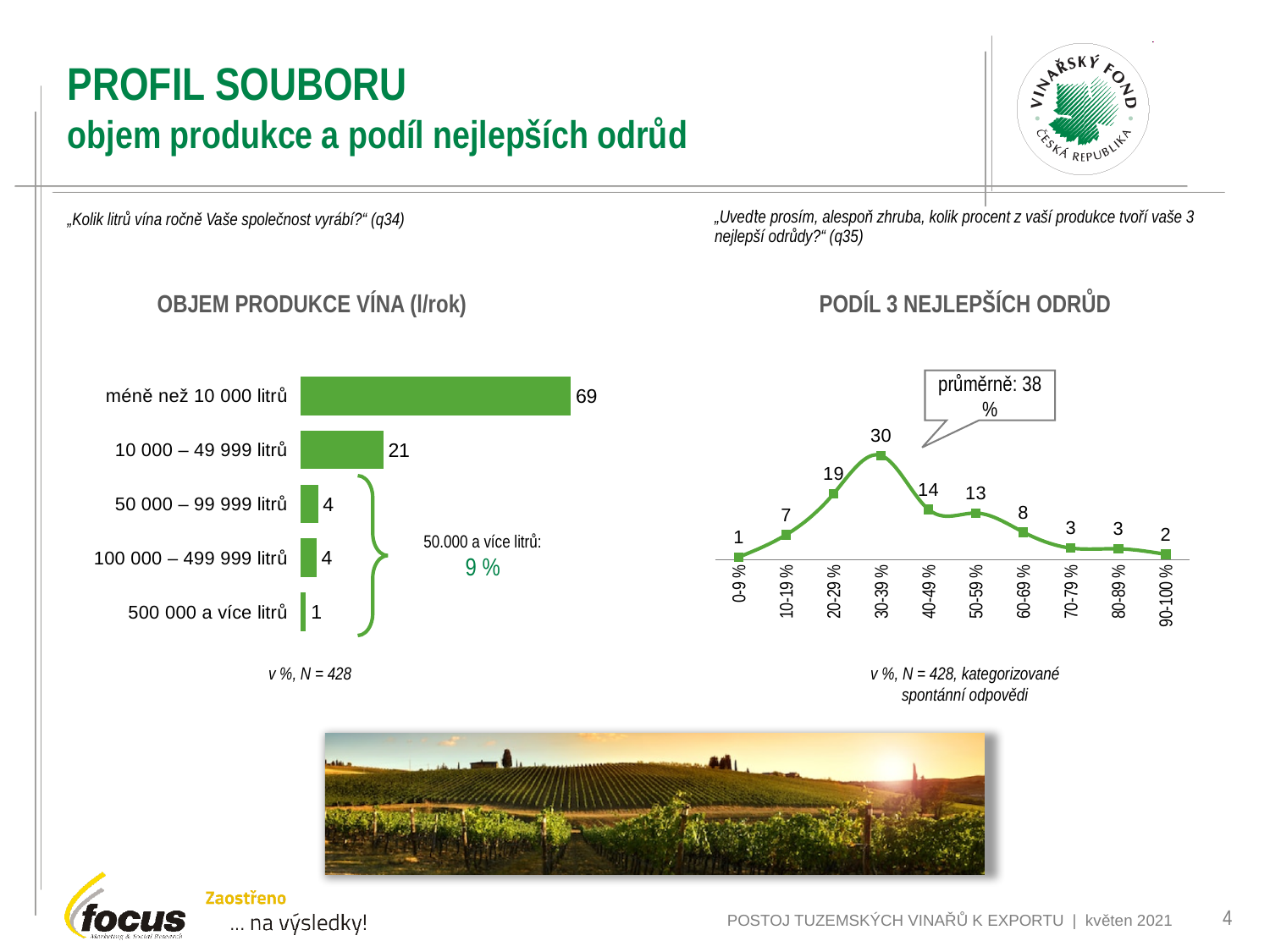
In the chart titled OBJEM PRODUKCE VÍNA (l/rok), how many categories are shown? 5 In the chart titled OBJEM PRODUKCE VÍNA (l/rok), which category has the lowest value? 500 000 a více litrů In the chart titled PODÍL 3 NEJLEPŠÍCH ODRŮD, what is the value for '60-69 %'? 8 In the chart titled PODÍL 3 NEJLEPŠÍCH ODRŮD, what average value is shown in the callout? 38 % In the chart titled PODÍL 3 NEJLEPŠÍCH ODRŮD, how many data points are plotted? 10 In the chart titled OBJEM PRODUKCE VÍNA (l/rok), what is the difference between the values for 'méně než 10 000 litrů' and '10 000 – 49 999 litrů'? 48 In the chart titled PODÍL 3 NEJLEPŠÍCH ODRŮD, which category has the highest value? 30-39 % What kind of chart is the one titled OBJEM PRODUKCE VÍNA (l/rok)? bar chart In the chart titled PODÍL 3 NEJLEPŠÍCH ODRŮD, what is the value for '30-39 %'? 30 In the chart titled OBJEM PRODUKCE VÍNA (l/rok), what is the value for 'méně než 10 000 litrů'? 69 In the chart titled PODÍL 3 NEJLEPŠÍCH ODRŮD, which is larger, the value for '20-29 %' or the value for '40-49 %'? 20-29 % In the chart titled OBJEM PRODUKCE VÍNA (l/rok), what is the value for '10 000 – 49 999 litrů'? 21